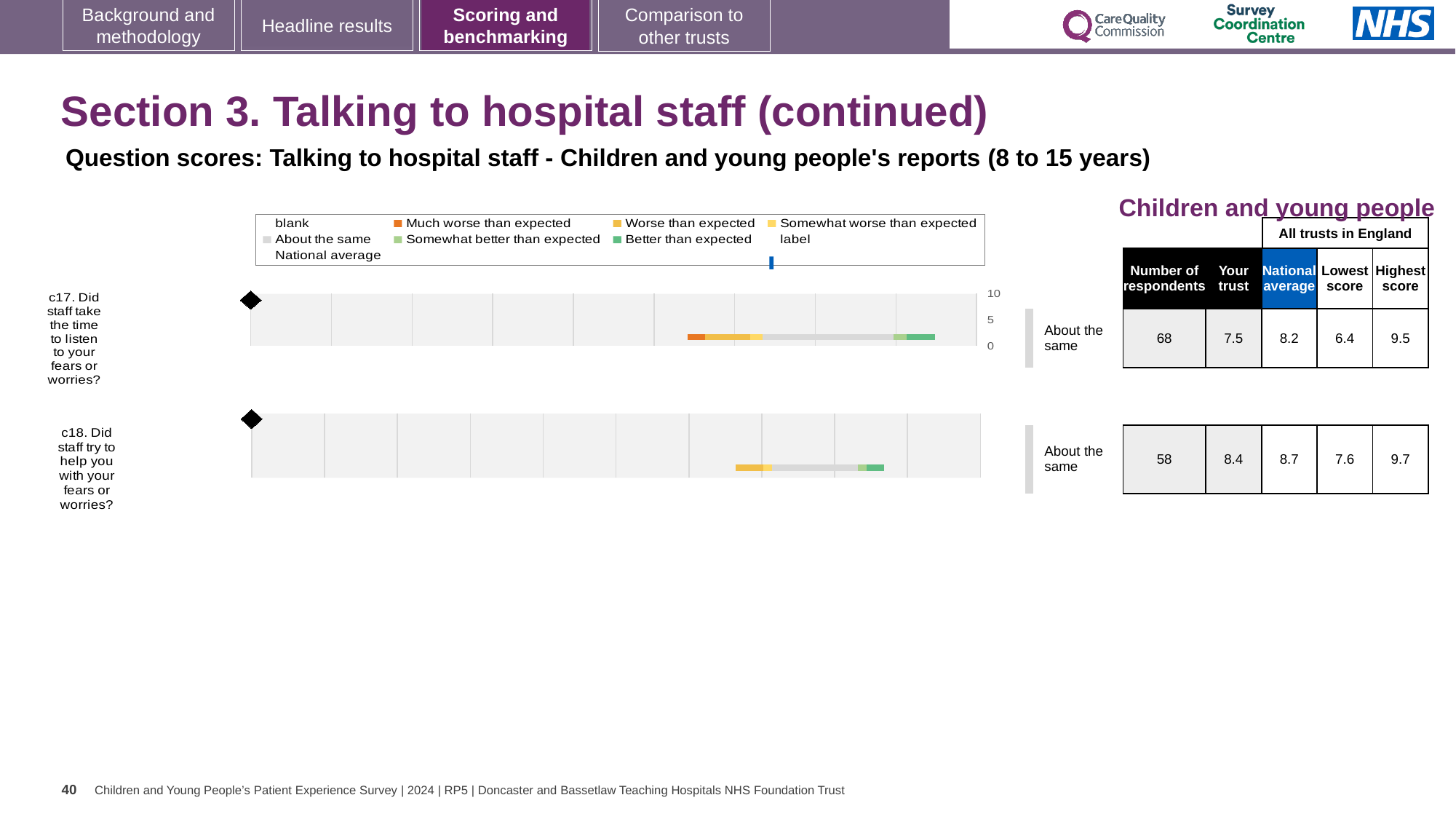
What benchmark category is shown for c17? About the same How many respondents answered question c17? 68 What colour does the legend use for 'Much worse than expected'? orange How much higher is the national average than the trust's score for c17? 0.7 How many survey questions are plotted on the slide? 2 What is the lowest score among all trusts in England for c17? 6.4 Which question has the higher national average score? c18 What is the difference between the highest and lowest trust scores for c18? 2.1 What is the national average score for c18 (Did staff try to help you with your fears or worries?)? 8.7 What kind of chart is used to show the question scores for c17 and c18? bar chart Which question has the higher 'Your trust' score, c17 or c18? c18 What is the 'Your trust' score for c17 (Did staff take the time to listen to your fears or worries?)? 7.5